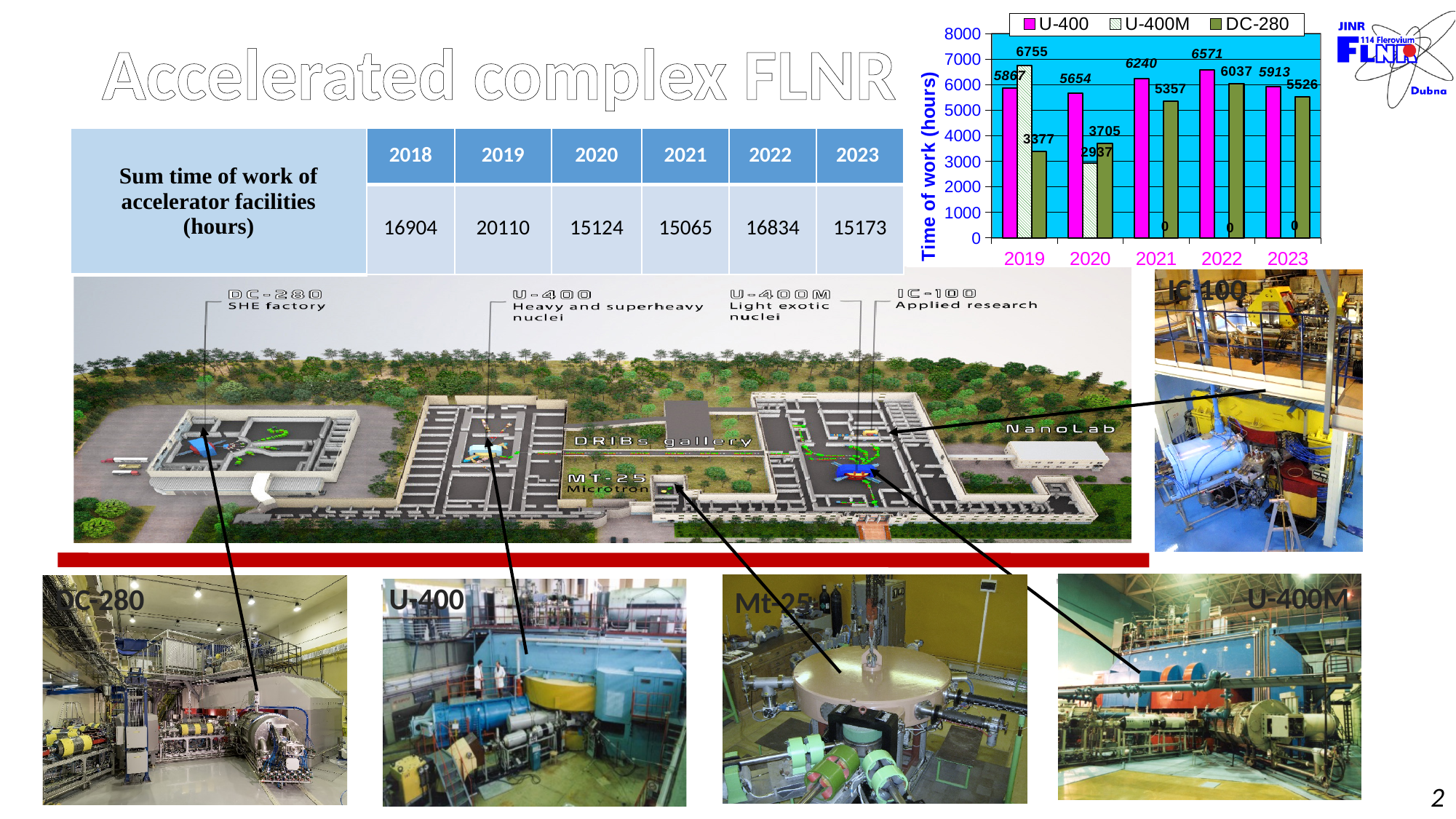
In the bar chart, what is the value for U-400M in 2023? 0 In the bar chart, what is the difference between the U-400 and DC-280 values in 2020? 1949 In the bar chart, what is the time of work for U-400M in 2019? 6755 How many series does the legend of the bar chart list? 3 In the bar chart, what is the time of work for U-400 in 2022? 6571 How many years are shown on the x axis of the bar chart? 5 In the bar chart, which year has the lowest value for DC-280? 2019 In the bar chart, which year has the highest value for U-400? 2022 In the bar chart, what is the time of work for DC-280 in 2021? 5357 In the bar chart, which is larger in 2019: U-400 or U-400M? U-400M What type of chart is shown in the top right of the slide? bar chart What is the label of the y axis of the bar chart? Time of work (hours)